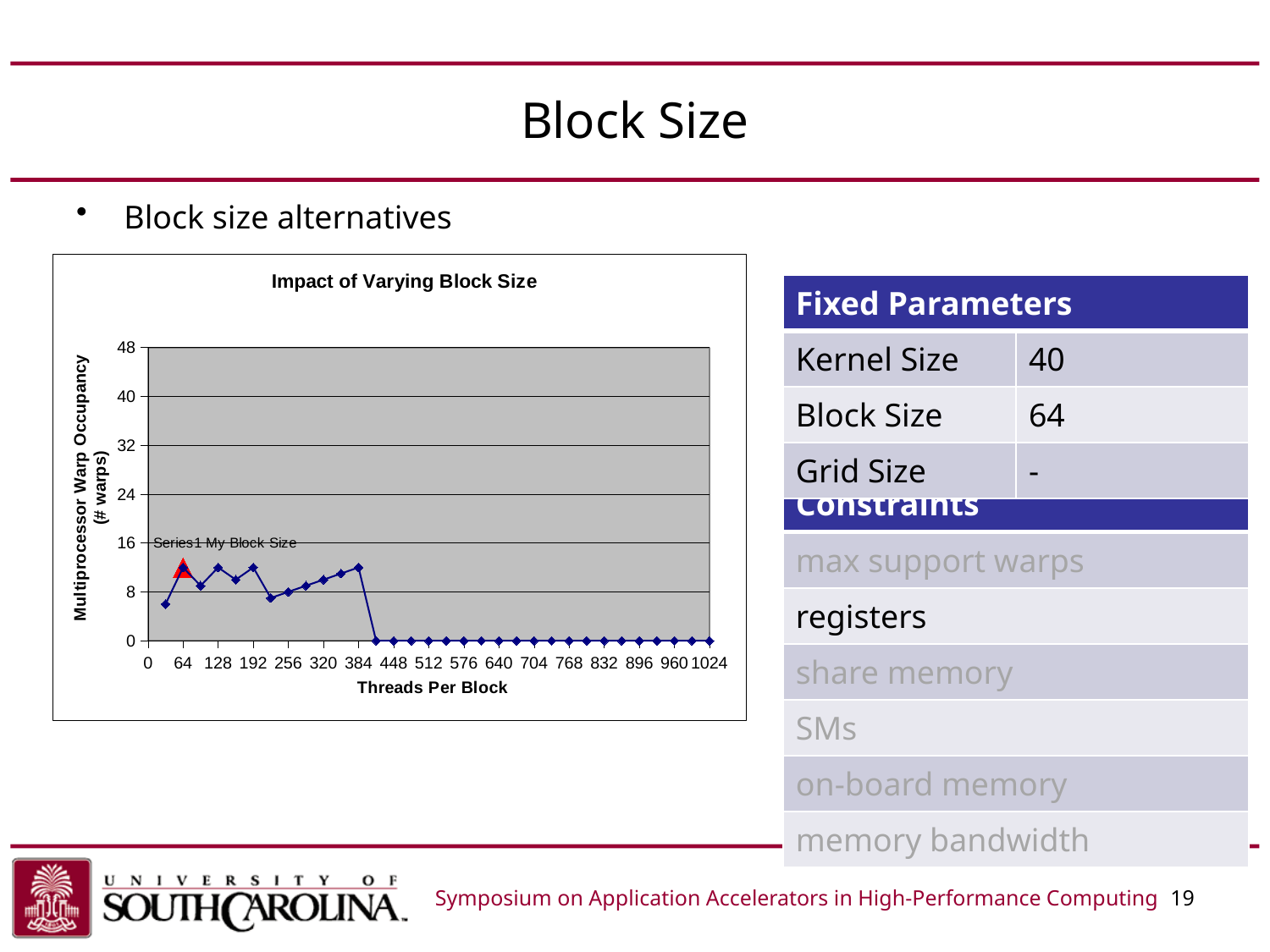
In the "Impact of Varying Block Size" chart, what is the warp occupancy at 512 threads per block? 0 In the "Impact of Varying Block Size" chart, does the warp occupancy rise or fall between 384 and 448 threads per block? fall In the "Impact of Varying Block Size" chart, is the warp occupancy at 32 threads per block greater or less than 8? less What kind of chart is "Impact of Varying Block Size"? line chart What are the two legend entries in the "Impact of Varying Block Size" chart? Series1, My Block Size In the "Impact of Varying Block Size" chart, is the warp occupancy at 384 threads per block greater or less than 16? less What is the label of the x axis in the "Impact of Varying Block Size" chart? Threads Per Block In the "Impact of Varying Block Size" chart, which has the higher warp occupancy: 192 threads per block or 224 threads per block? 192 In the "Impact of Varying Block Size" chart, which has the higher warp occupancy: 64 threads per block or 32 threads per block? 64 How many series does the legend of the "Impact of Varying Block Size" chart list? 2 In the "Impact of Varying Block Size" chart, what is the warp occupancy at 1024 threads per block? 0 In the "Impact of Varying Block Size" chart, is the warp occupancy at 64 threads per block greater or less than 8? greater